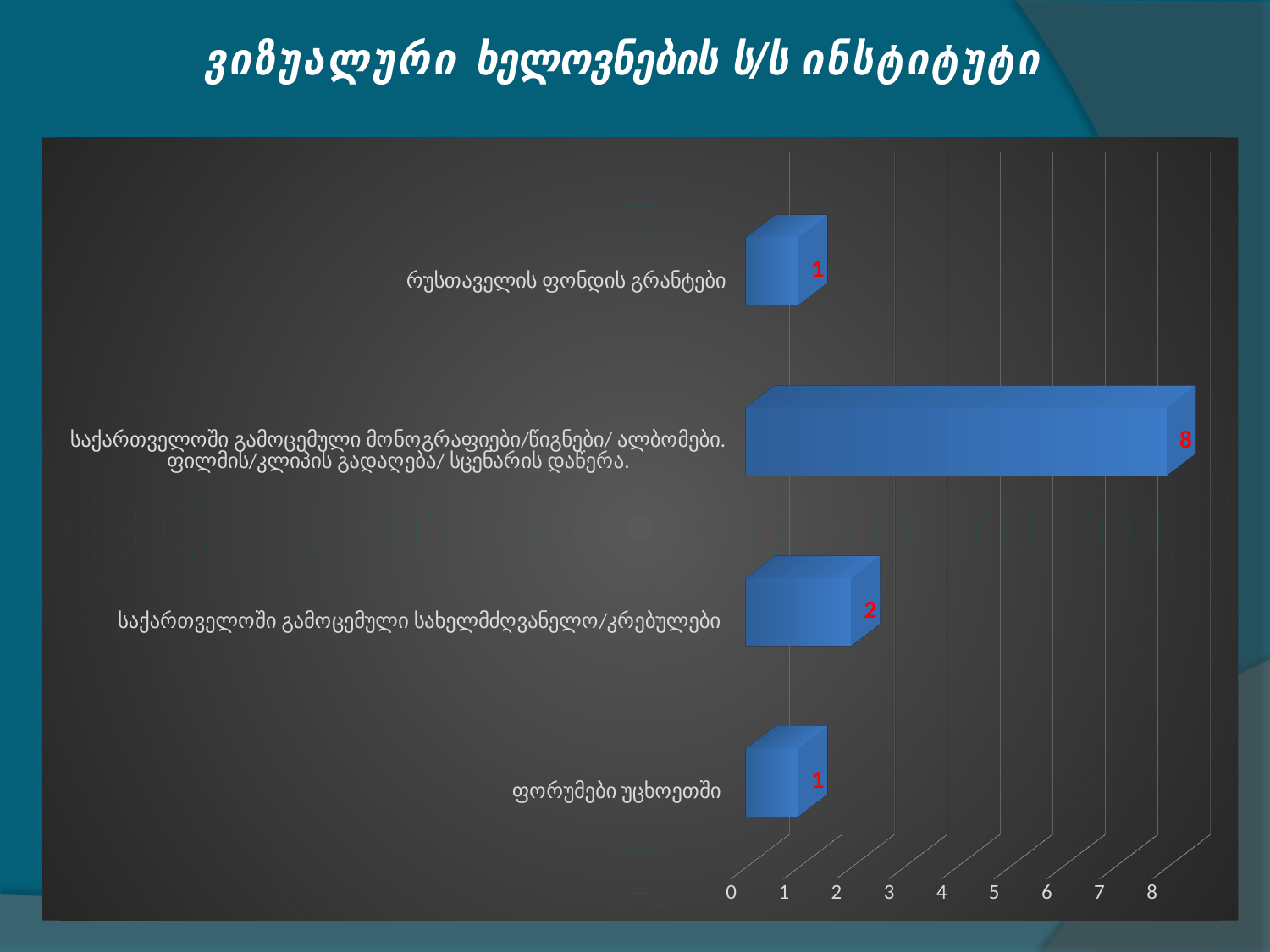
Which is larger: the value for საქართველოში გამოცემული სახელმძღვანელო/კრებულები or the value for ფორუმები უცხოეთში? საქართველოში გამოცემული სახელმძღვანელო/კრებულები Is the value for საქართველოში გამოცემული მონოგრაფიები/წიგნები/ ალბომები. ფილმის/კლიპის გადაღება/ სცენარის დაწერა. greater or less than 5? greater What is the value for რუსთაველის ფონდის გრანტები? 1 What type of chart is shown on the slide? bar chart What is the difference between the value for საქართველოში გამოცემული მონოგრაფიები/წიგნები/ ალბომები. ფილმის/კლიპის გადაღება/ სცენარის დაწერა. and the value for საქართველოში გამოცემული სახელმძღვანელო/კრებულები? 6 What is the highest tick value shown on the horizontal axis? 8 What is the value for საქართველოში გამოცემული მონოგრაფიები/წიგნები/ ალბომები. ფილმის/კლიპის გადაღება/ სცენარის დაწერა.? 8 What is the value for ფორუმები უცხოეთში? 1 Which category has the highest value? საქართველოში გამოცემული მონოგრაფიები/წიგნები/ ალბომები. ფილმის/კლიპის გადაღება/ სცენარის დაწერა. How many categories are plotted in the chart? 4 What is the title of the slide? ვიზუალური ხელოვნების ს/ს ინსტიტუტი What is the value for საქართველოში გამოცემული სახელმძღვანელო/კრებულები? 2